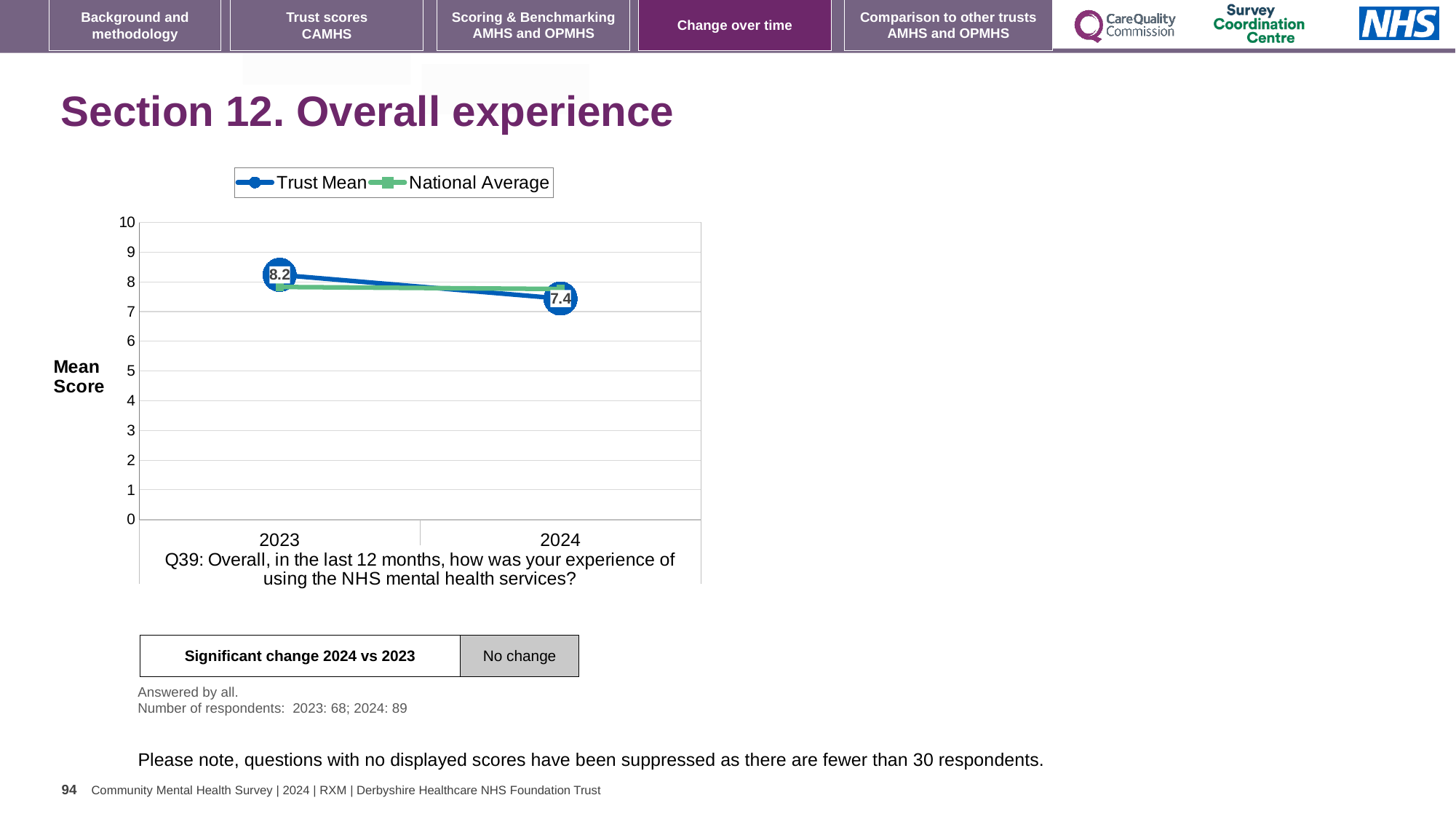
What are the two series named in the legend? Trust Mean and National Average What is the Trust Mean value for 2023? 8.2 Is the National Average value for 2024 greater or less than 9? less By how much did the Trust Mean change from 2023 to 2024? 0.8 How many years are plotted on the x axis? 2 How many series does the legend list? 2 Which year has the higher Trust Mean, 2023 or 2024? 2023 What kind of chart is shown on the slide? line chart What is the label on the y axis of the chart? Mean Score What is the Trust Mean value for 2024? 7.4 Is the National Average value for 2023 greater or less than 7? greater Does the Trust Mean rise or fall from 2023 to 2024? fall